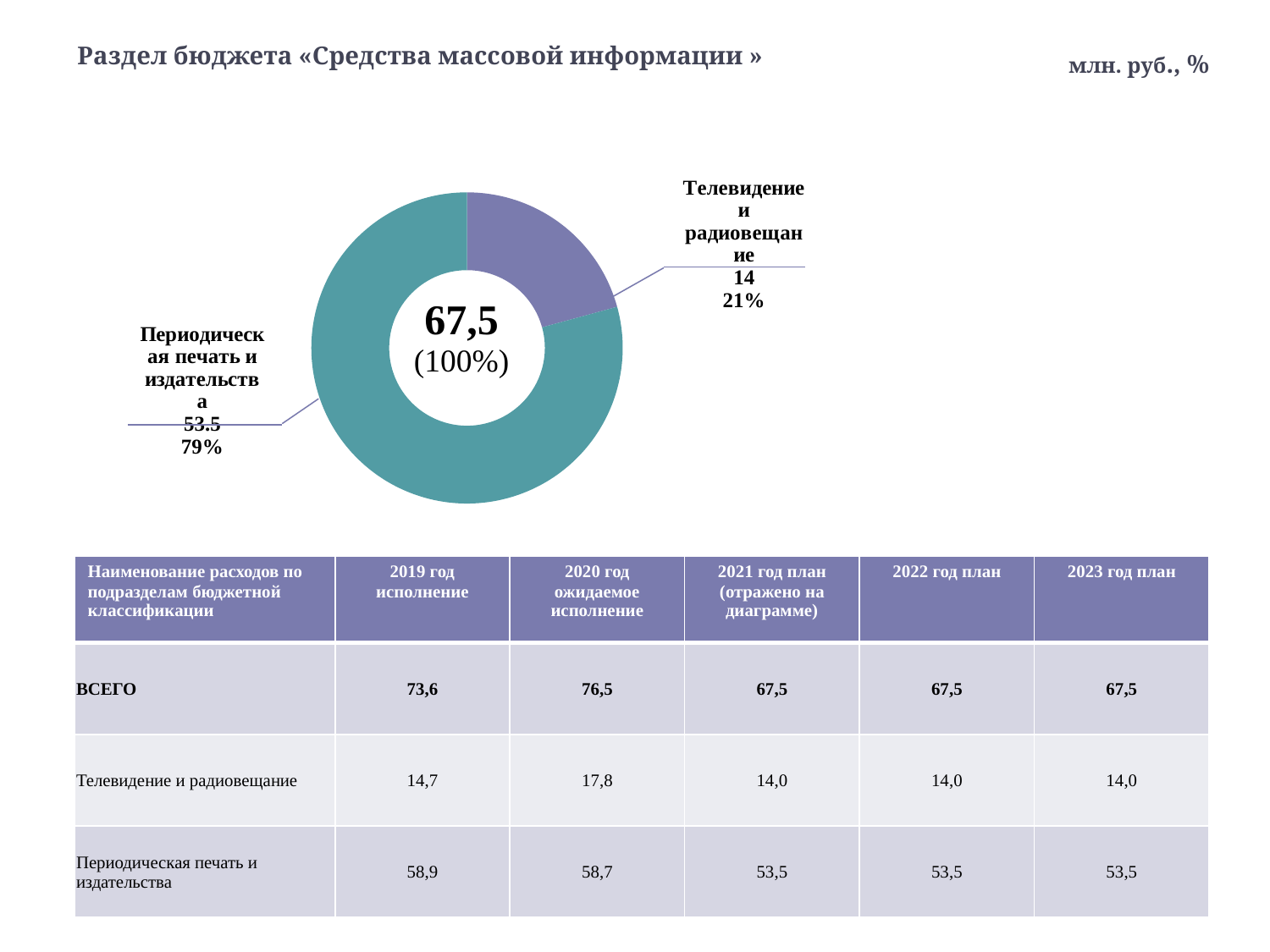
How many slices does the donut chart have? 2 What value is shown for «Периодическая печать и издательства» on the donut chart? 53.5 By how much does the value for «Периодическая печать и издательства» exceed the value for «Телевидение и радиовещание» on the donut chart? 39.5 What total value is shown in the centre of the donut chart? 67,5 Which slice of the donut chart is the largest? Периодическая печать и издательства What kind of chart is shown on the slide? Pie (donut) chart Which is larger on the donut chart: «Телевидение и радиовещание» or «Периодическая печать и издательства»? Периодическая печать и издательства What is the title of the slide containing the donut chart? Раздел бюджета «Средства массовой информации » What value is shown for «Телевидение и радиовещание» on the donut chart? 14 What share of the donut chart does «Телевидение и радиовещание» represent? 21% Which slice of the donut chart is the smallest? Телевидение и радиовещание What share of the donut chart does «Периодическая печать и издательства» represent? 79%